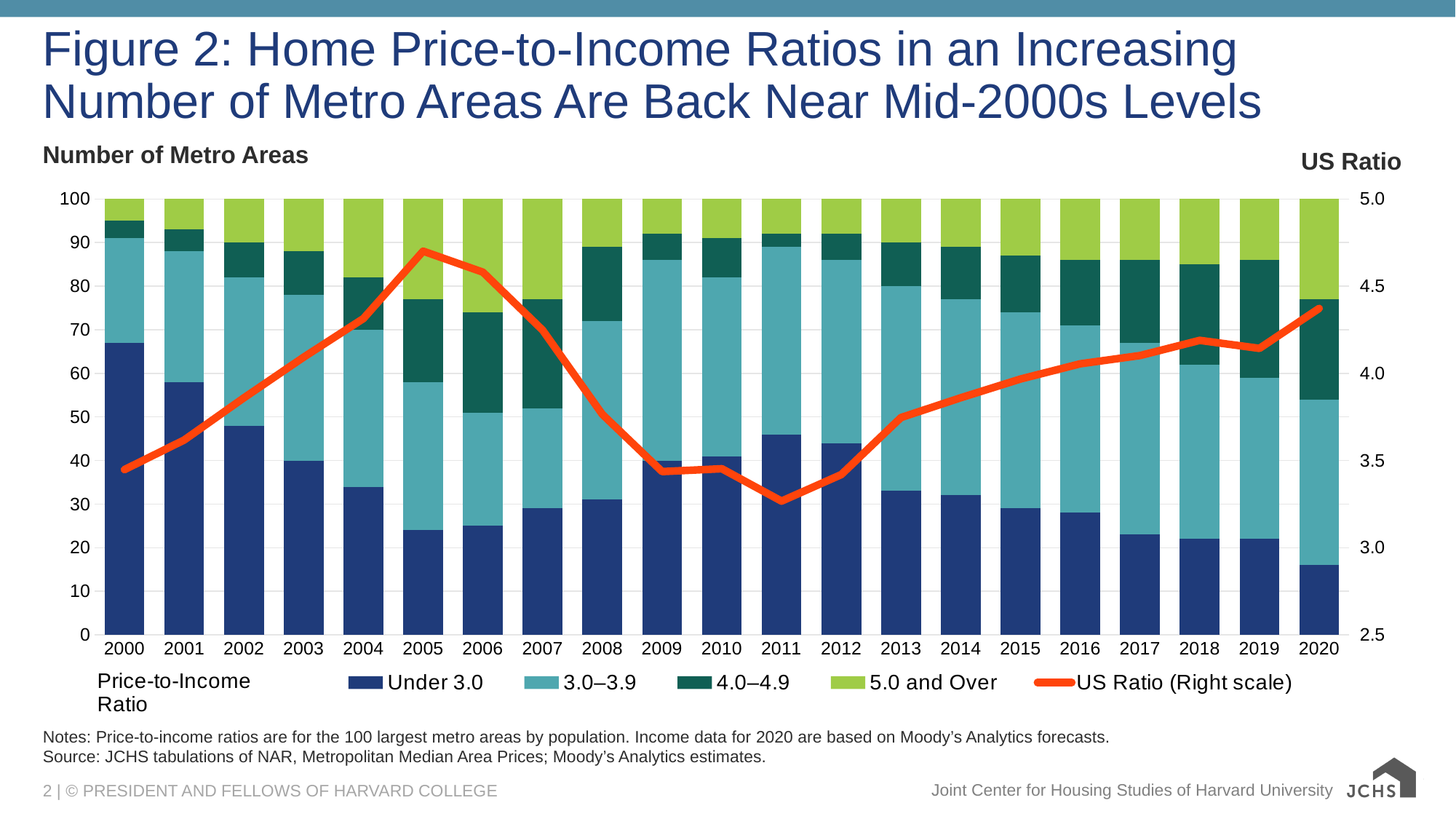
In which year does the US Ratio line reach its highest point? 2005 What is the total height of the stacked bar for 2010? 100 Is the US Ratio in 2005 greater or less than 4.5? greater What type of chart is shown on the slide? Stacked bar chart with a line Is the Under 3.0 segment larger in 2000 or in 2020? 2000 How many years are shown along the x axis? 21 What is the label of the left vertical axis? Number of Metro Areas Is the number of metro areas with a price-to-income ratio Under 3.0 in 2020 greater or less than 20? less In which year does the US Ratio line reach its lowest point? 2011 How many series does the legend list? 5 Does the US Ratio rise or fall from 2011 to 2020? rise Is the number of metro areas with a price-to-income ratio Under 3.0 in 2000 greater or less than 60? greater